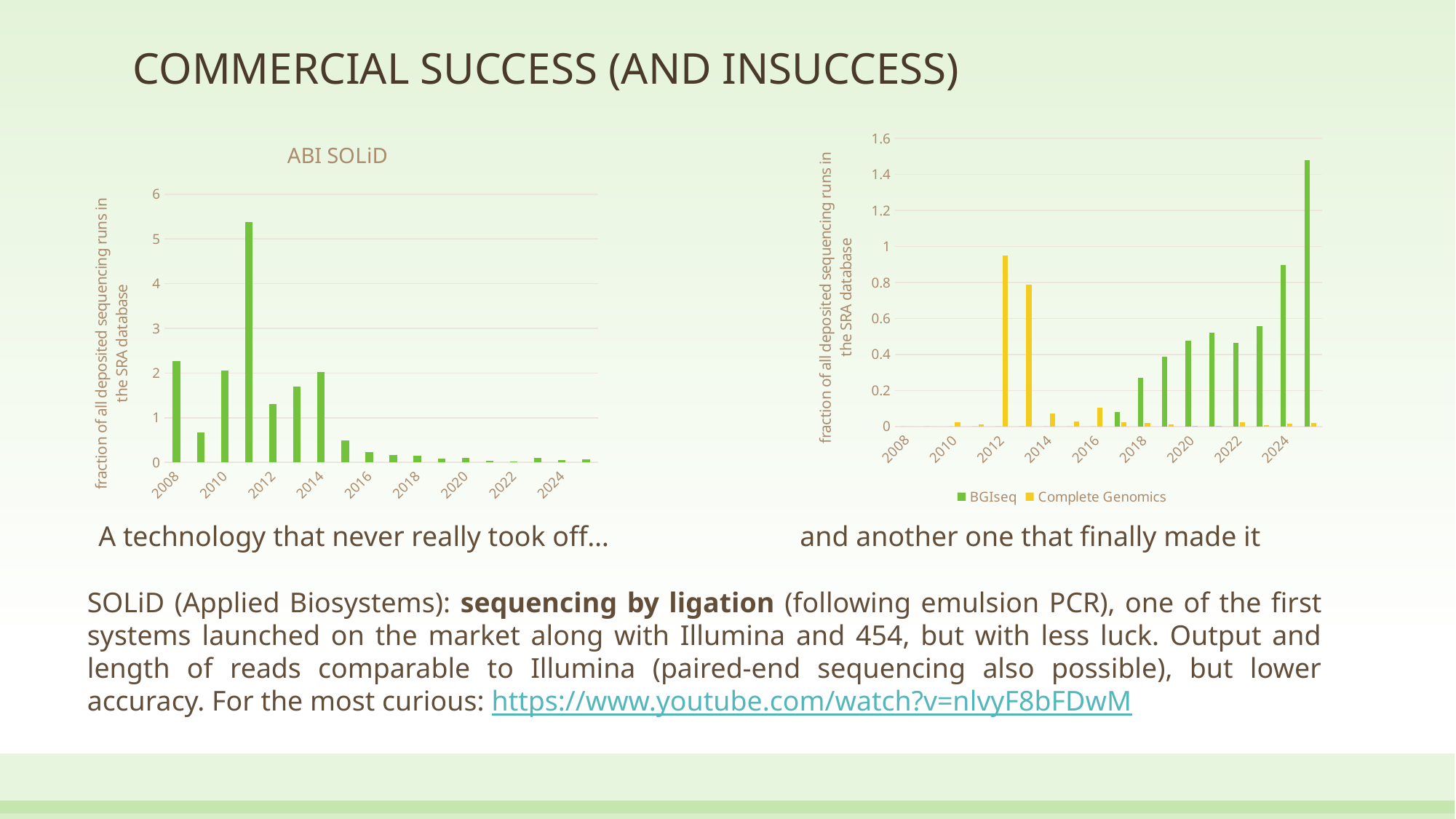
In the ABI SOLiD chart, which year has the highest fraction of deposited sequencing runs? 2011 What is the title of the chart on the left? ABI SOLiD How many series does the legend of the chart on the right list? 2 What are the two series named in the legend of the chart on the right? BGIseq and Complete Genomics In the ABI SOLiD chart, which is larger, the value for 2011 or the value for 2014? 2011 In the ABI SOLiD chart, is the value for 2008 greater or less than 2? greater In the chart on the right, which year has the highest Complete Genomics value? 2012 In the chart on the right, is the BGIseq value for 2024 greater or less than 0.8? greater In the chart on the right, which series has the tallest bar overall? BGIseq What kind of chart is the ABI SOLiD chart on the left? bar chart In the ABI SOLiD chart, is the value for 2011 greater or less than 5? greater In the ABI SOLiD chart, do the values generally rise or fall from 2014 to 2024? fall